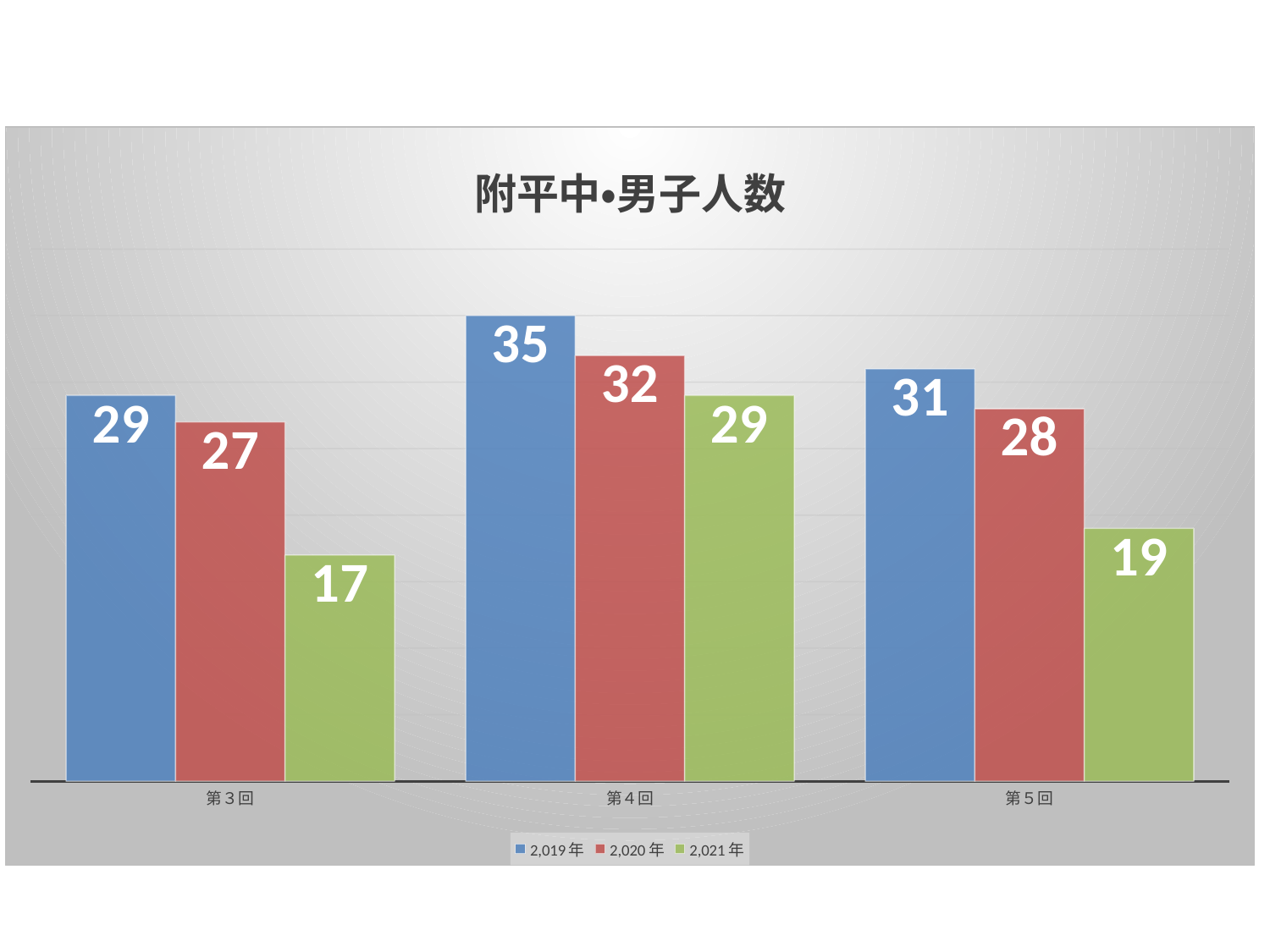
Which category has the lowest value for the 2,021年 series? 第3回 How many categories are shown on the x axis? 3 What kind of chart is shown on the slide? bar chart Which category has the highest value for the 2,019年 series? 第4回 How many series does the legend list? 3 What is the title of the chart? 附平中•男子人数 Which is larger at 第4回: the 2,020年 value or the 2,021年 value? 2,020年 Which colour represents the 2,021年 series? green What is the difference between the 2,019年 and 2,021年 values at 第5回? 12 What is the value for 2,019年 at 第4回? 35 What is the value for 2,020年 at 第5回? 28 What is the value for 2,021年 at 第3回? 17